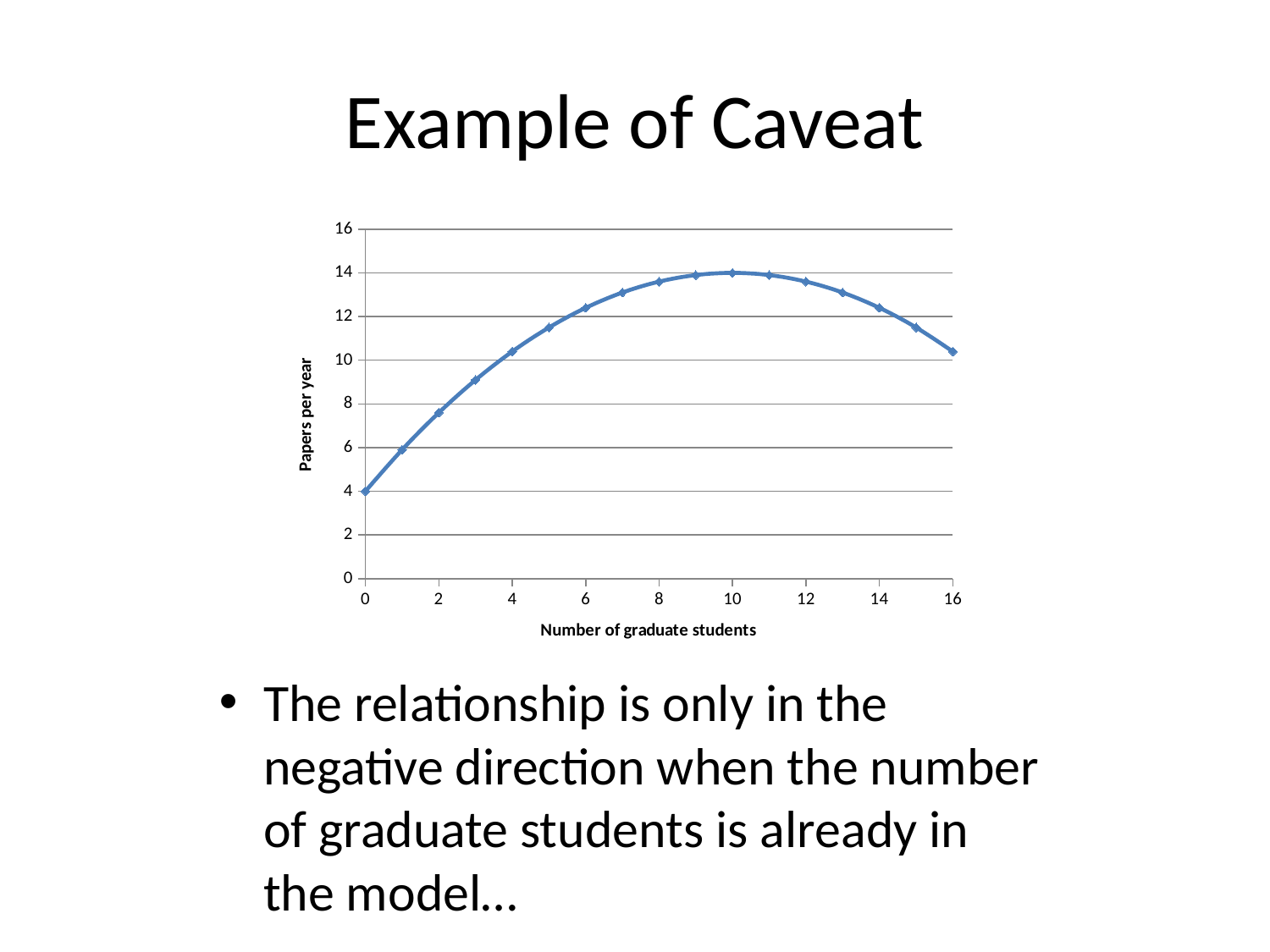
What is the label of the y axis? Papers per year Which is larger, papers per year at 2 graduate students or at 14 graduate students? 14 graduate students What kind of chart is shown on the slide? line chart What is the label of the x axis? Number of graduate students Is the value of papers per year at 16 graduate students greater or less than 12? less What is the value of papers per year when the number of graduate students is 0? 4 What is the value of papers per year when the number of graduate students is 10? 14 How do papers per year change as the number of graduate students increases from 10 to 16? they fall Is the value of papers per year at 4 graduate students greater or less than 8? greater At which number of graduate students is papers per year highest? 10 At which number of graduate students is papers per year lowest? 0 How many data points are plotted on the line? 17